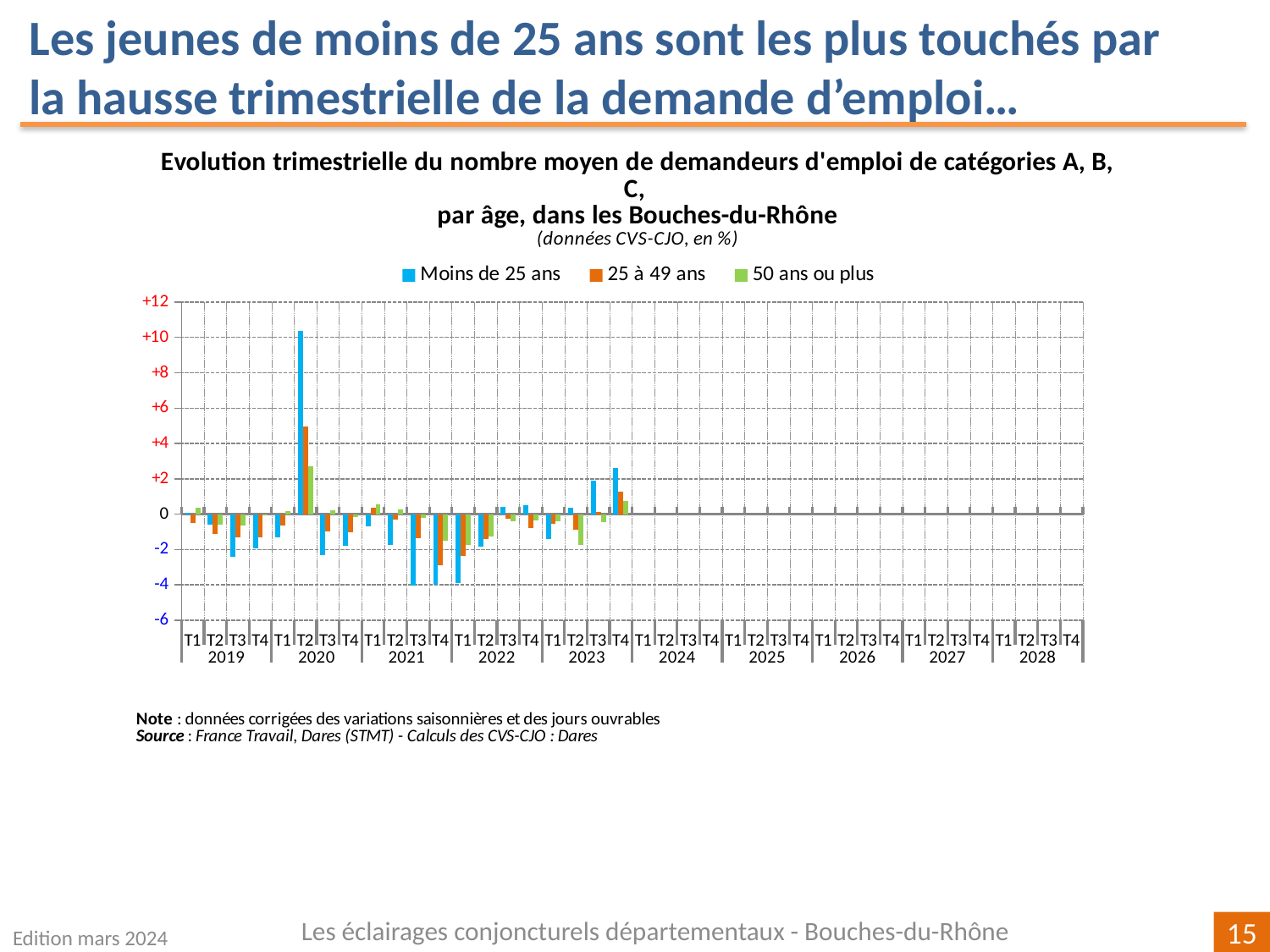
In T4 2023, which is larger: the value for 'Moins de 25 ans' or for '50 ans ou plus'? Moins de 25 ans In which quarter does the 'Moins de 25 ans' series reach its highest value? T2 2020 How many series does the legend list? 3 Is the value for '25 à 49 ans' in T2 2020 greater or less than +4? greater Which series reaches the highest value on the chart? Moins de 25 ans Is the value for 'Moins de 25 ans' in T2 2020 greater or less than +8? greater Which colour represents the '50 ans ou plus' series in the legend? green How many years are labeled on the x axis? 10 In T2 2020, which is larger: the value for 'Moins de 25 ans' or for '25 à 49 ans'? Moins de 25 ans Across the four quarters of 2023, do the values for 'Moins de 25 ans' rise or fall? rise Is the value for 'Moins de 25 ans' in T3 2021 greater or less than -2? less What kind of chart is shown on the slide? bar chart